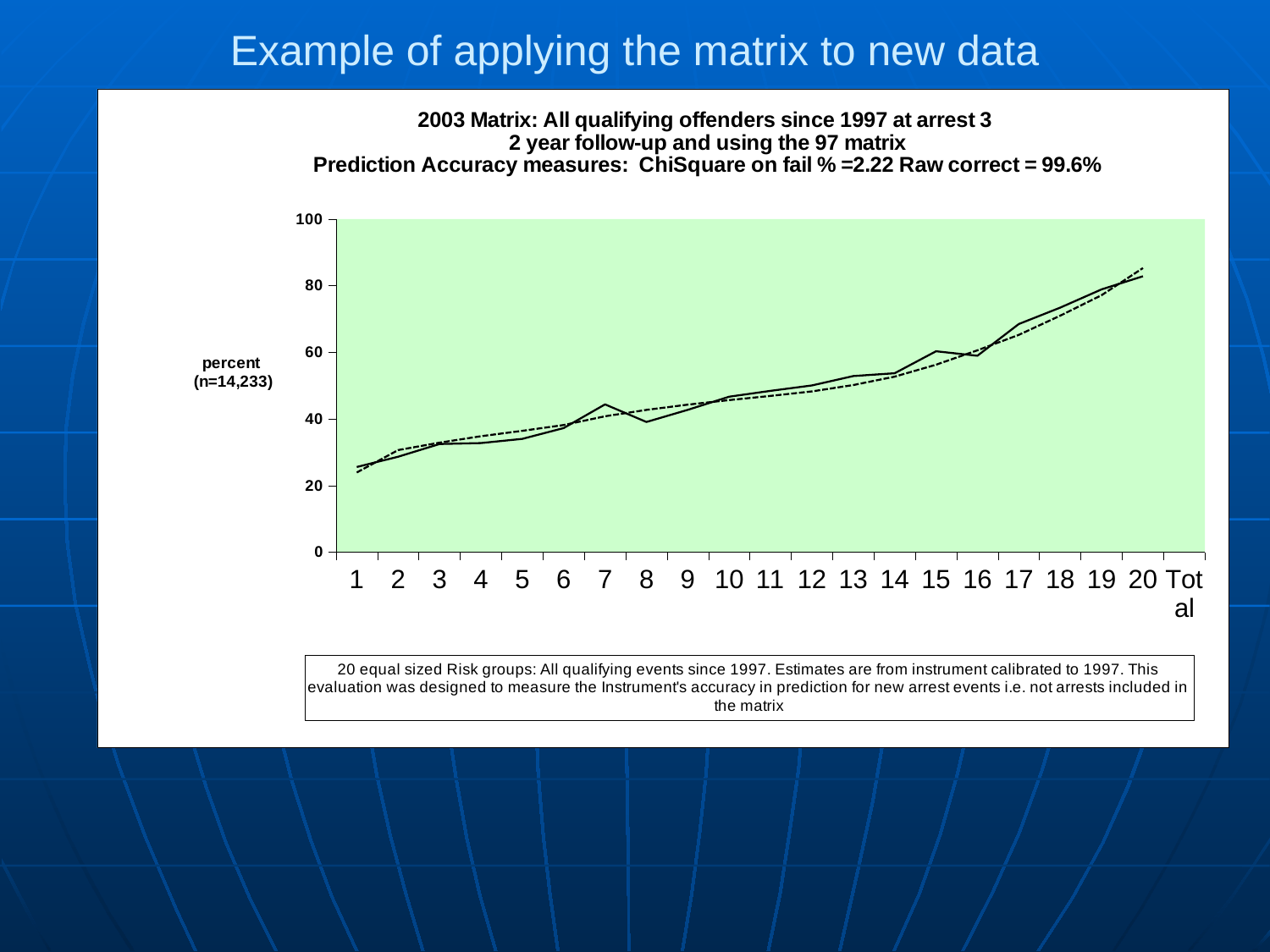
Do the plotted values generally rise or fall as the risk group number increases from 1 to 20? rise Which numbered risk group has the lowest value on the solid line? 1 Is the value of the solid line for risk group 10 greater or less than 60? less What is the label on the y axis of the chart? percent (n=14,233) Which numbered risk group has the highest value on the solid line? 20 Is the value of the solid line for risk group 20 greater or less than 60? greater Is the value of the solid line for risk group 1 greater or less than 40? less How many numbered risk groups are shown on the x axis? 20 Which is larger on the solid line: the value for risk group 3 or the value for risk group 18? risk group 18 How many lines are plotted on the chart? 2 What kind of chart is shown on the slide? line chart